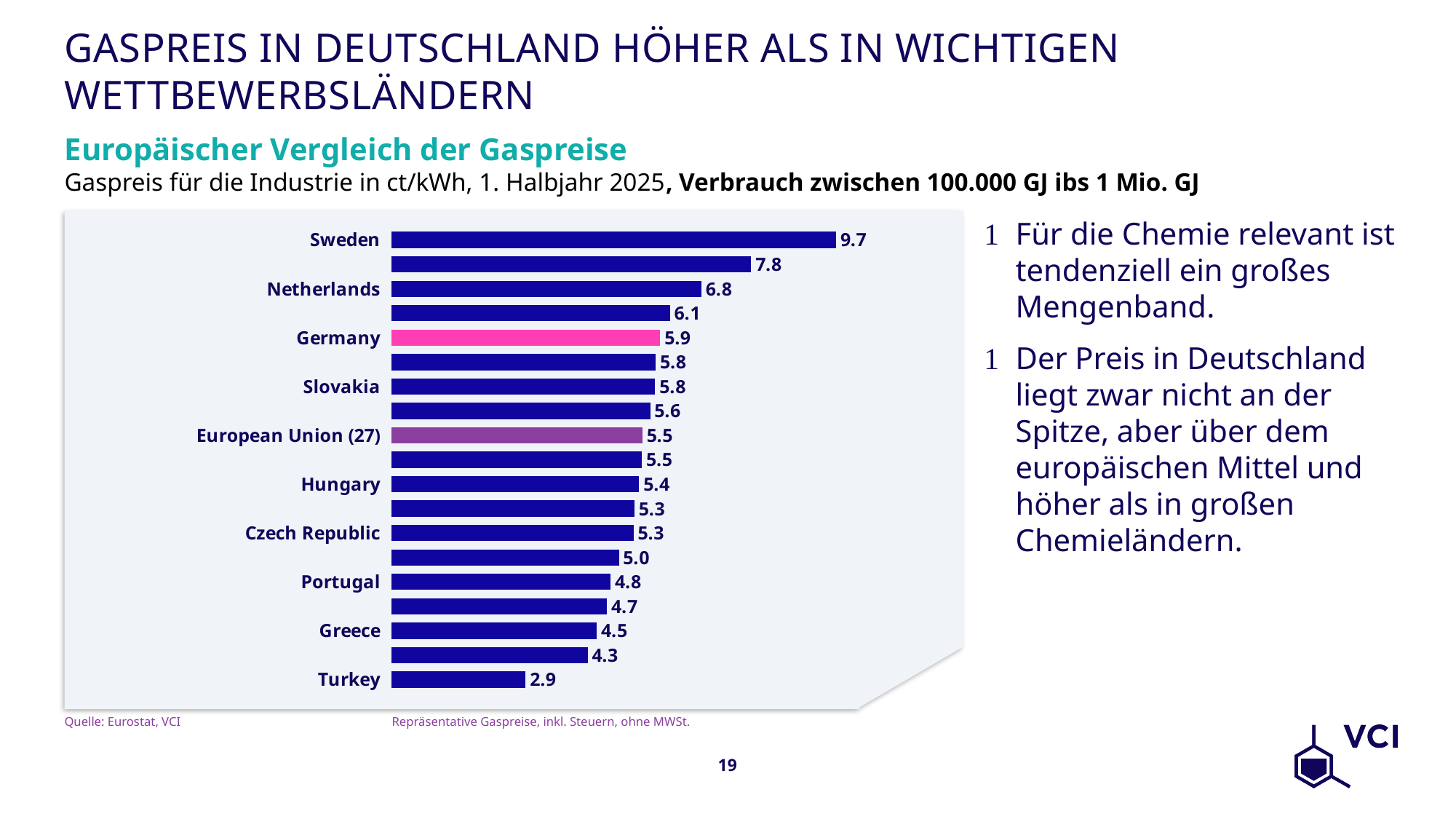
What is the gas price for Sweden? 9.7 How many bars are plotted in the chart? 19 What kind of chart is shown on the slide? Bar chart How much higher is the gas price in Germany than the European Union (27) value? 0.4 Which labelled country has the highest gas price? Sweden What is the value shown for European Union (27)? 5.5 Which labelled country has the lowest gas price? Turkey Which has a higher gas price, Netherlands or Hungary? Netherlands What is the gas price for Germany? 5.9 What colour is the bar for Germany? Pink What is the difference between the gas prices of Sweden and Turkey? 6.8 What is the gas price for Turkey? 2.9